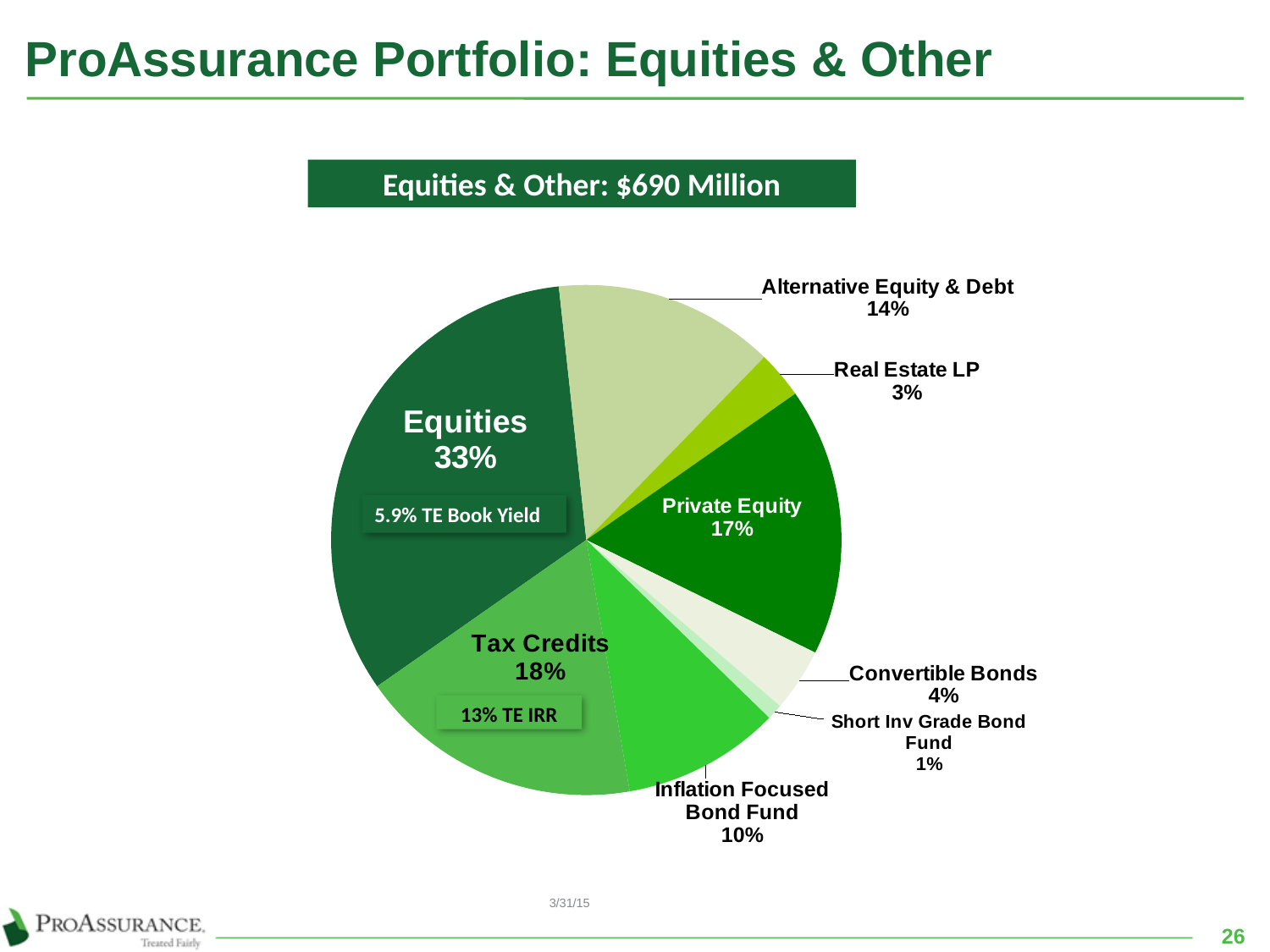
What percentage is shown for Private Equity? 17% How many categories are shown in the pie chart? 8 Which category has the largest slice of the pie? Equities What percentage is shown for Tax Credits? 18% What is the difference in percentage points between Equities and Tax Credits? 15 What share of the pie does Equities hold? 33% Which category has the smallest slice of the pie? Short Inv Grade Bond Fund What kind of chart is shown on the slide? Pie chart What TE Book Yield is shown for the Equities slice? 5.9% Which is larger, Alternative Equity & Debt or Inflation Focused Bond Fund? Alternative Equity & Debt What percentage is shown for Real Estate LP? 3% What total value is given for Equities & Other in the header above the chart? $690 Million